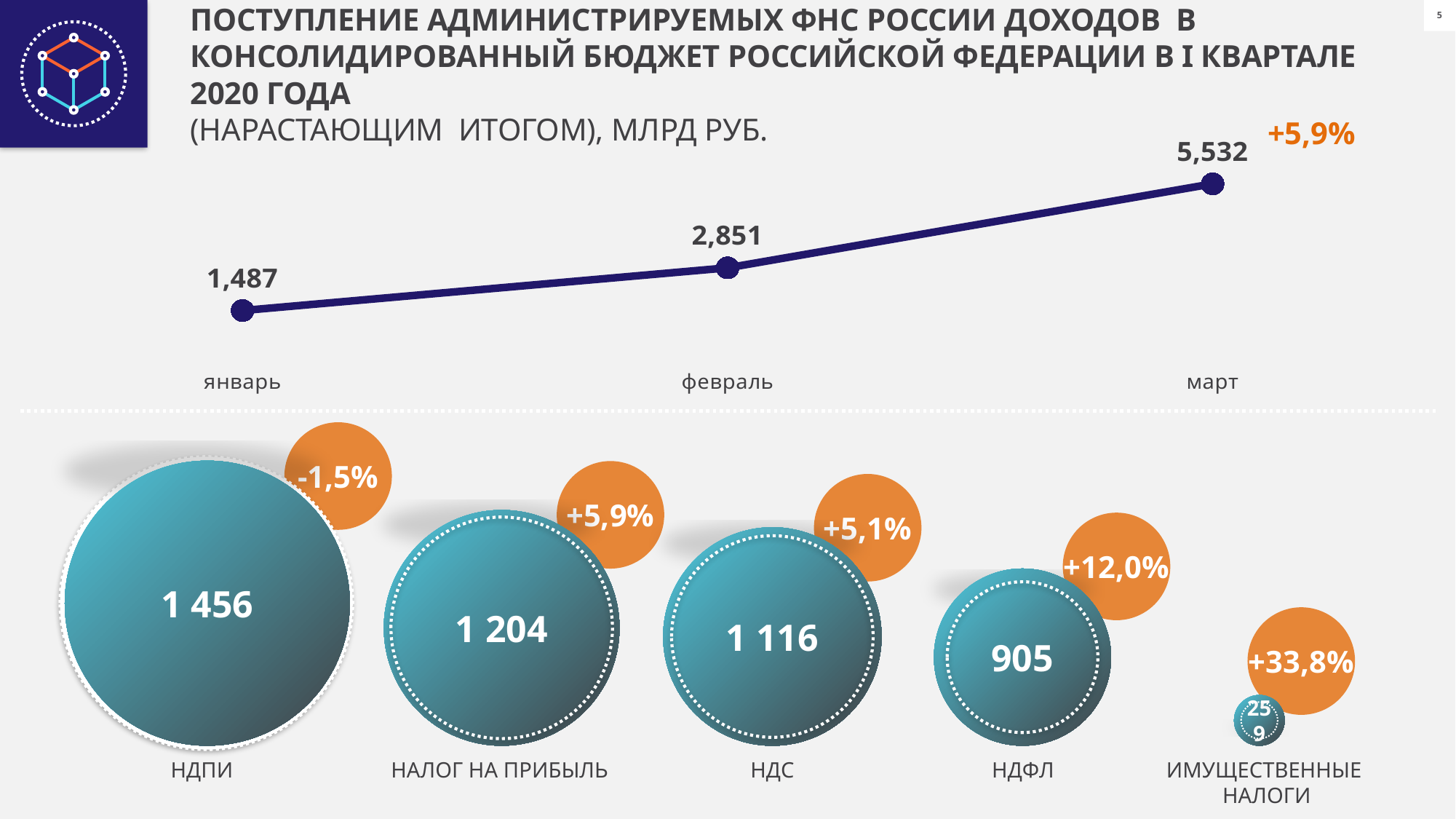
In the line chart at the top of the slide, what is the value for февраль? 2,851 In the line chart at the top of the slide, how many data points are plotted? 3 In the bubble chart at the bottom of the slide, what is the value for НДС? 1 116 In the bubble chart at the bottom of the slide, what is the value for НДФЛ? 905 In the line chart at the top of the slide, what is the value for март? 5,532 What kind of chart is shown at the top of the slide? line chart In the line chart at the top of the slide, what percentage change is shown next to the март value? +5,9% In the line chart at the top of the slide, what is the value for январь? 1,487 In the bubble chart at the bottom of the slide, what is the value for НДПИ? 1 456 In the line chart at the top of the slide, do the values rise or fall from январь to март? rise In the bubble chart at the bottom of the slide, what percentage change is shown for ИМУЩЕСТВЕННЫЕ НАЛОГИ? +33,8% In the bubble chart at the bottom of the slide, which category has the highest value? НДПИ